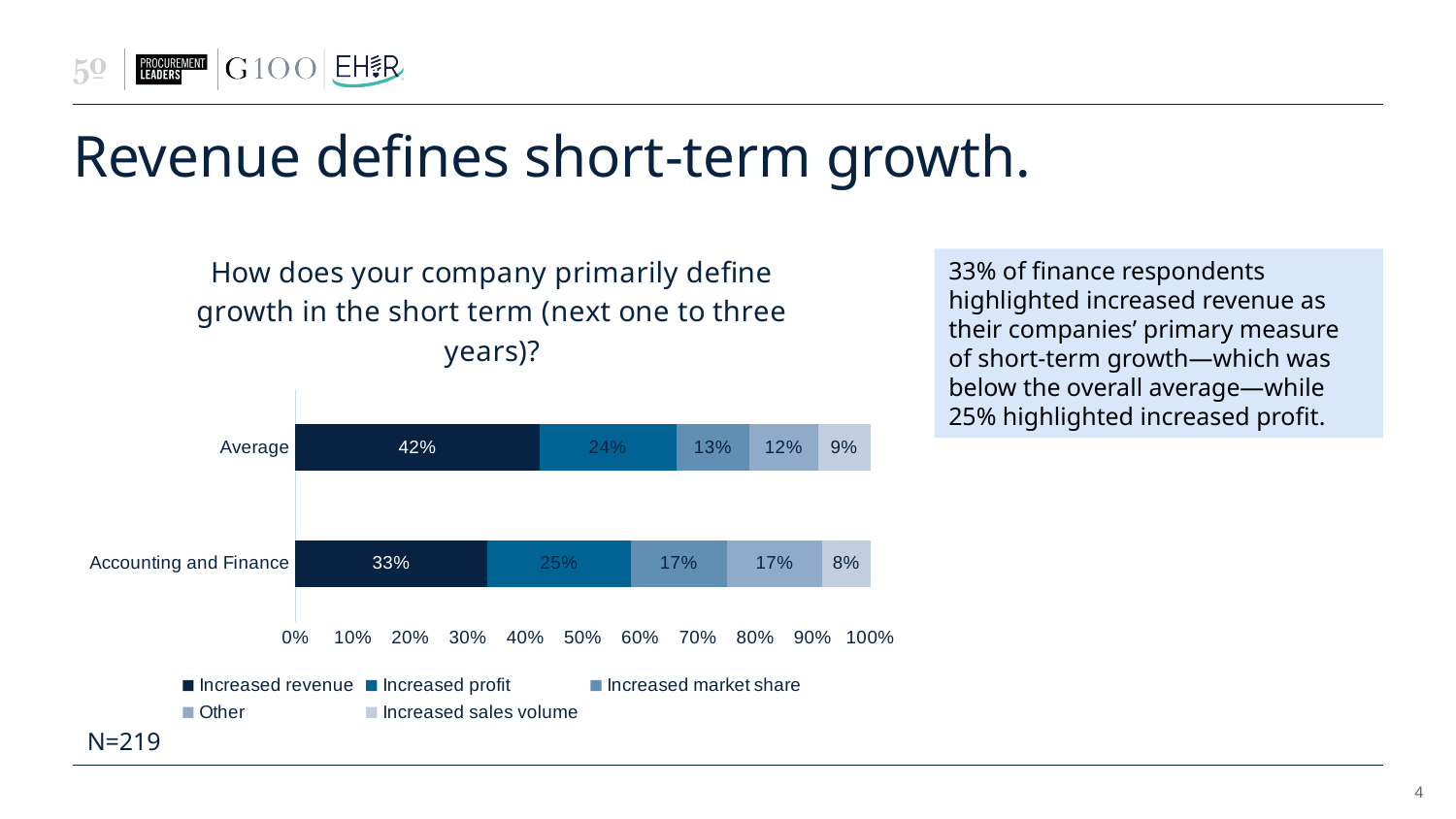
Which segment is the smallest in the Average bar? Increased sales volume What is the title of the chart? How does your company primarily define growth in the short term (next one to three years)? What percentage of Average respondents selected Increased revenue? 42% What is the Increased market share value for the Average bar? 13% How many series does the legend list? 5 What is the difference between the Increased revenue values for Average and Accounting and Finance? 9 percentage points What kind of chart is shown on the slide? Stacked bar chart What percentage of Accounting and Finance respondents selected Increased profit? 25% Which is larger: the Other value for Average or for Accounting and Finance? Accounting and Finance What is the Increased sales volume value for the Accounting and Finance bar? 8% How many categories (bars) are plotted in the chart? 2 Which segment is the largest in the Accounting and Finance bar? Increased revenue